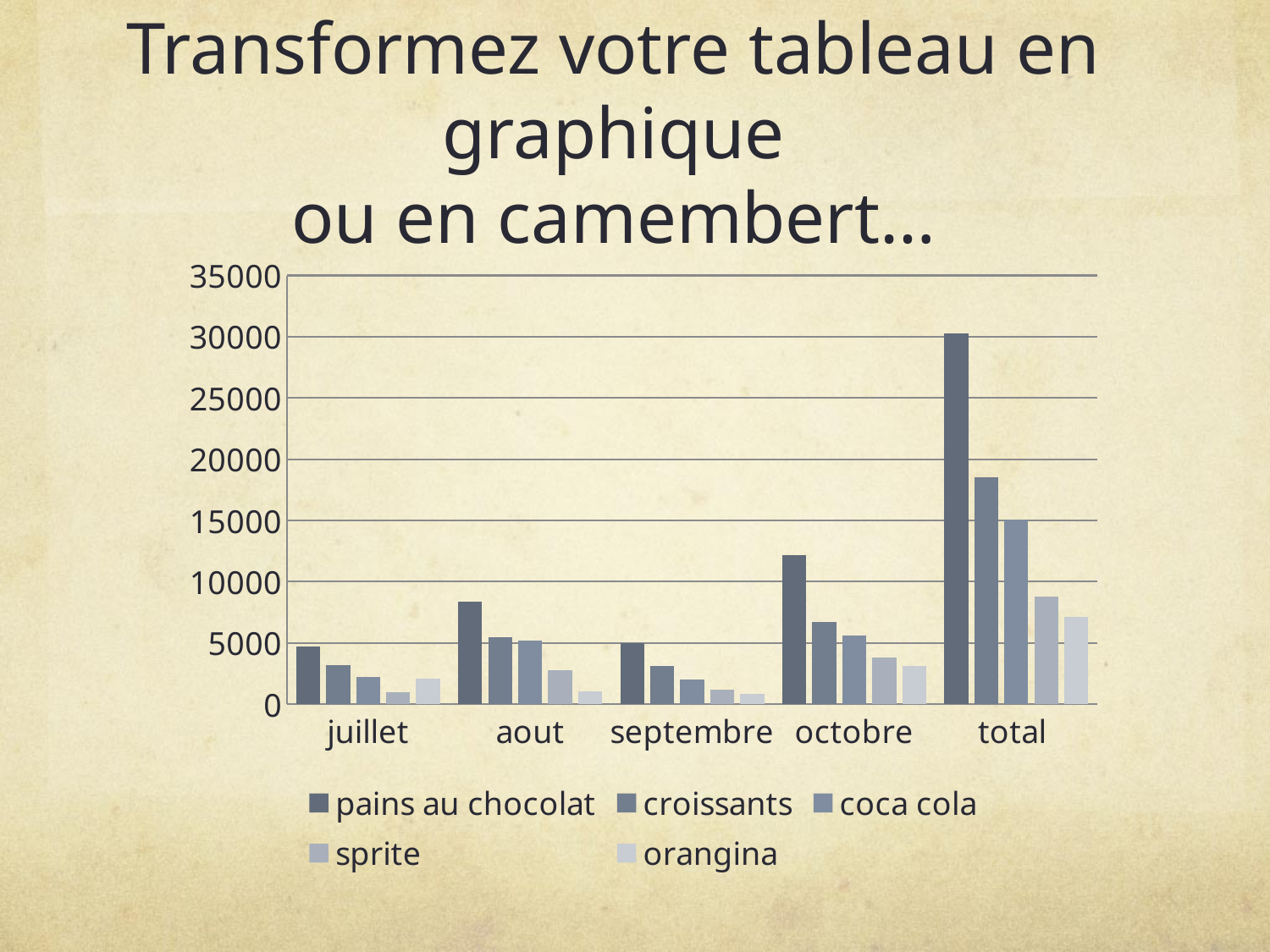
How many categories are shown on the x axis of the chart? 5 Is the value for sprite in the total category greater or less than 10000? less Is the value for pains au chocolat in the total category greater or less than 25000? greater Is the value for croissants in the total category greater or less than 20000? less Which series has the lowest value in the juillet category? sprite Which is larger: croissants in octobre or croissants in aout? croissants in octobre What kind of chart is shown on the slide? bar chart Which legend entry is listed first in the chart's legend? pains au chocolat Which series has the lowest value in the aout category? orangina How many series does the legend list? 5 Which series has the highest value in the octobre category? pains au chocolat